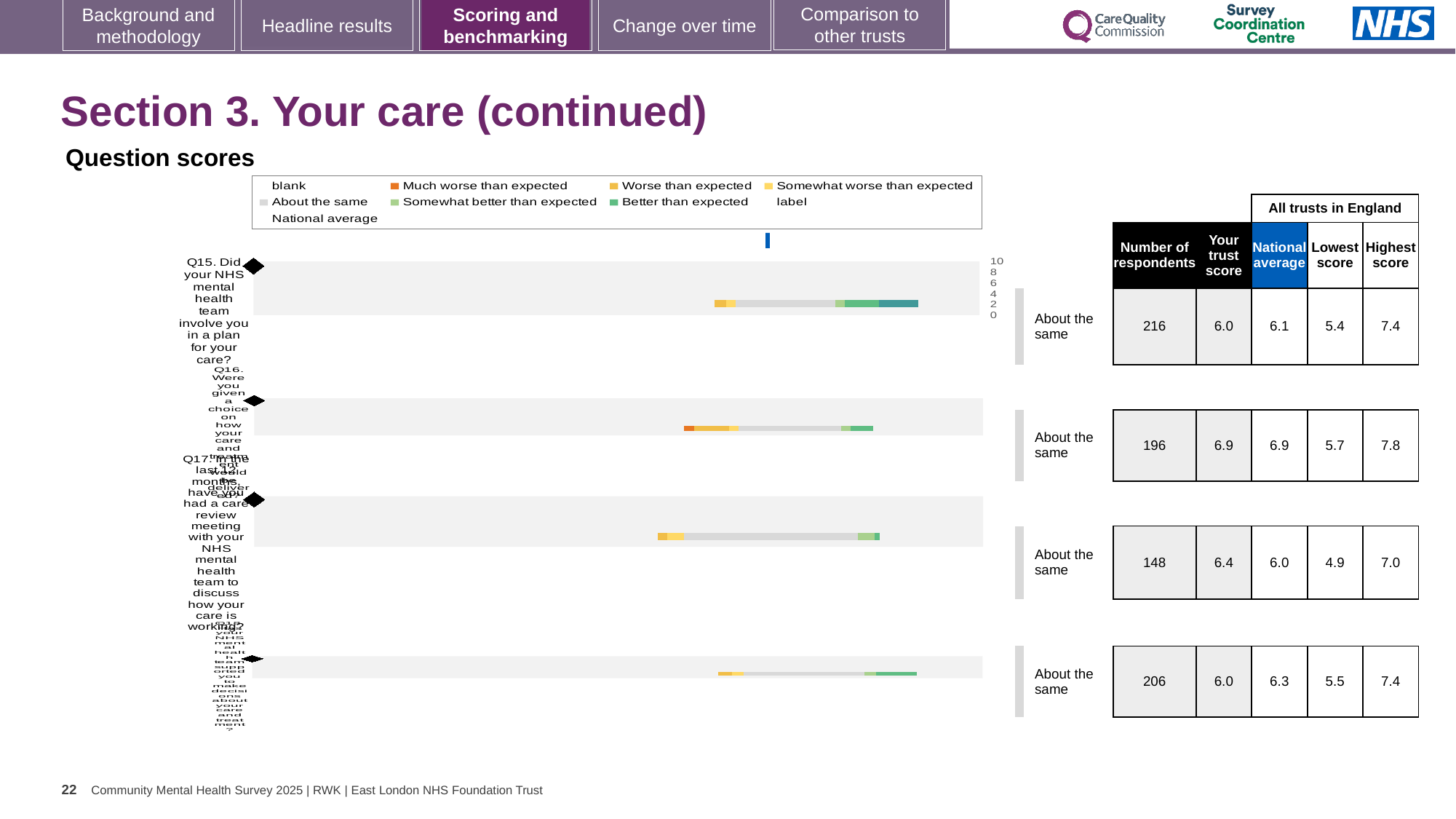
For Q17, is the trust score or the national average larger? trust score For Q17, what is the difference between the highest score and the lowest score across all trusts in England? 2.1 In the table beside the chart, what is the highest score across all trusts in England for Q16? 7.8 What kind of chart is used to show the question scores on this slide? bar chart What is the highest value shown on the chart's score axis? 10 In the table beside the chart, what is the national average for Q17 (care review meeting in the last 12 months)? 6.0 What is the title shown above the chart? Question scores Which question row has the lowest number of respondents in the table beside the chart? Q17 In the table beside the chart, what is the number of respondents for Q15 (involve you in a plan for your care)? 216 In the table beside the chart, what is the trust score for Q16 (given a choice on how your care and treatment would be delivered)? 6.9 Which question row has the highest number of respondents in the table beside the chart? Q15 How many questions (bars) are plotted in the question scores chart? 4